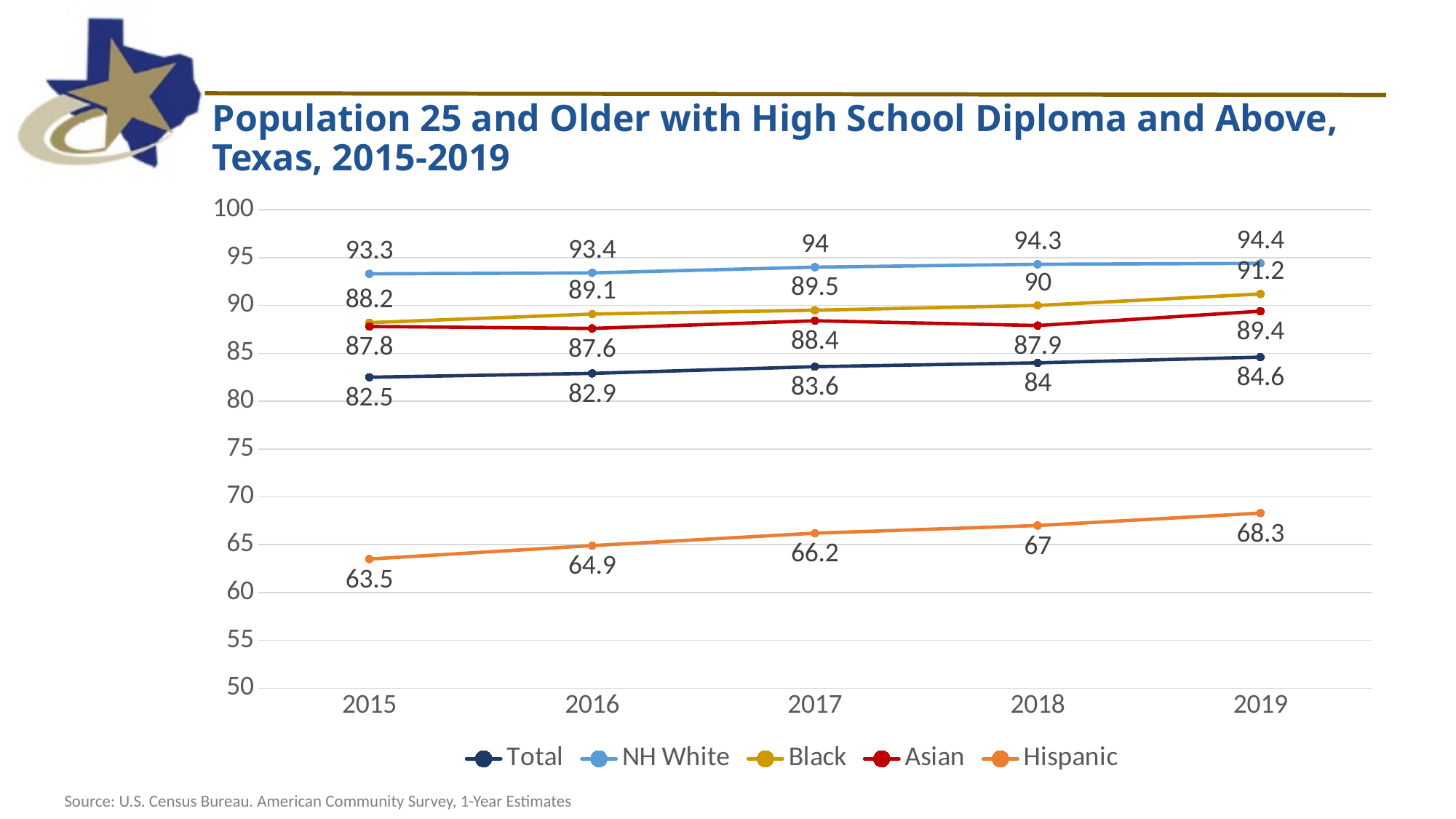
What is the value for NH White in 2019? 94.4 How many series does the legend list? 5 Which series has the highest value in 2017? NH White Does the Hispanic series rise or fall from 2015 to 2019? rise How many years are plotted on the x axis? 5 What is the difference between the NH White and Hispanic values in 2019? 26.1 What type of chart is shown on the slide? line chart Which series has the lowest value in 2019? Hispanic What is the value for Hispanic in 2015? 63.5 Which is larger in 2018, the Black value or the Asian value? Black What is the value for Black in 2018? 90 What is the value for Asian in 2016? 87.6